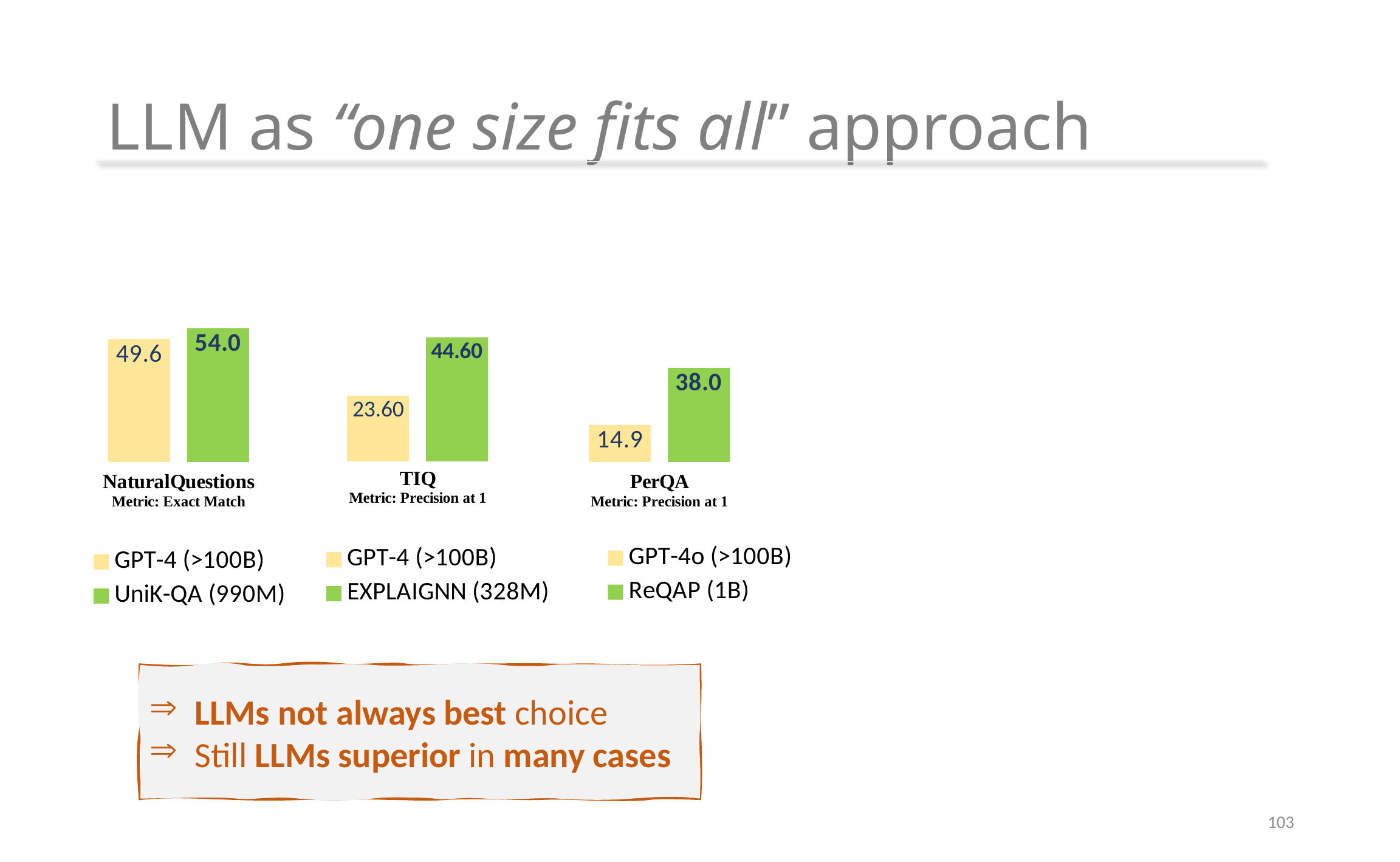
In the PerQA chart, what is the value for ReQAP (1B)? 38.0 In the TIQ chart, what is the difference between EXPLAIGNN (328M) and GPT-4 (>100B)? 21.00 What type of chart is used for the TIQ results? Bar chart In the NaturalQuestions chart, which system has the higher value, GPT-4 (>100B) or UniK-QA (990M)? UniK-QA (990M) In the PerQA chart, what is the difference between ReQAP (1B) and GPT-4o (>100B)? 23.1 In the NaturalQuestions chart, what is the value for UniK-QA (990M)? 54.0 In the PerQA chart, which system has the lowest value? GPT-4o (>100B) In the TIQ chart, what is the value for EXPLAIGNN (328M)? 44.60 In the NaturalQuestions chart, what is the value for GPT-4 (>100B)? 49.6 What metric is used for the NaturalQuestions chart? Exact Match In the PerQA chart, what is the value for GPT-4o (>100B)? 14.9 In the TIQ chart, what is the value for GPT-4 (>100B)? 23.60